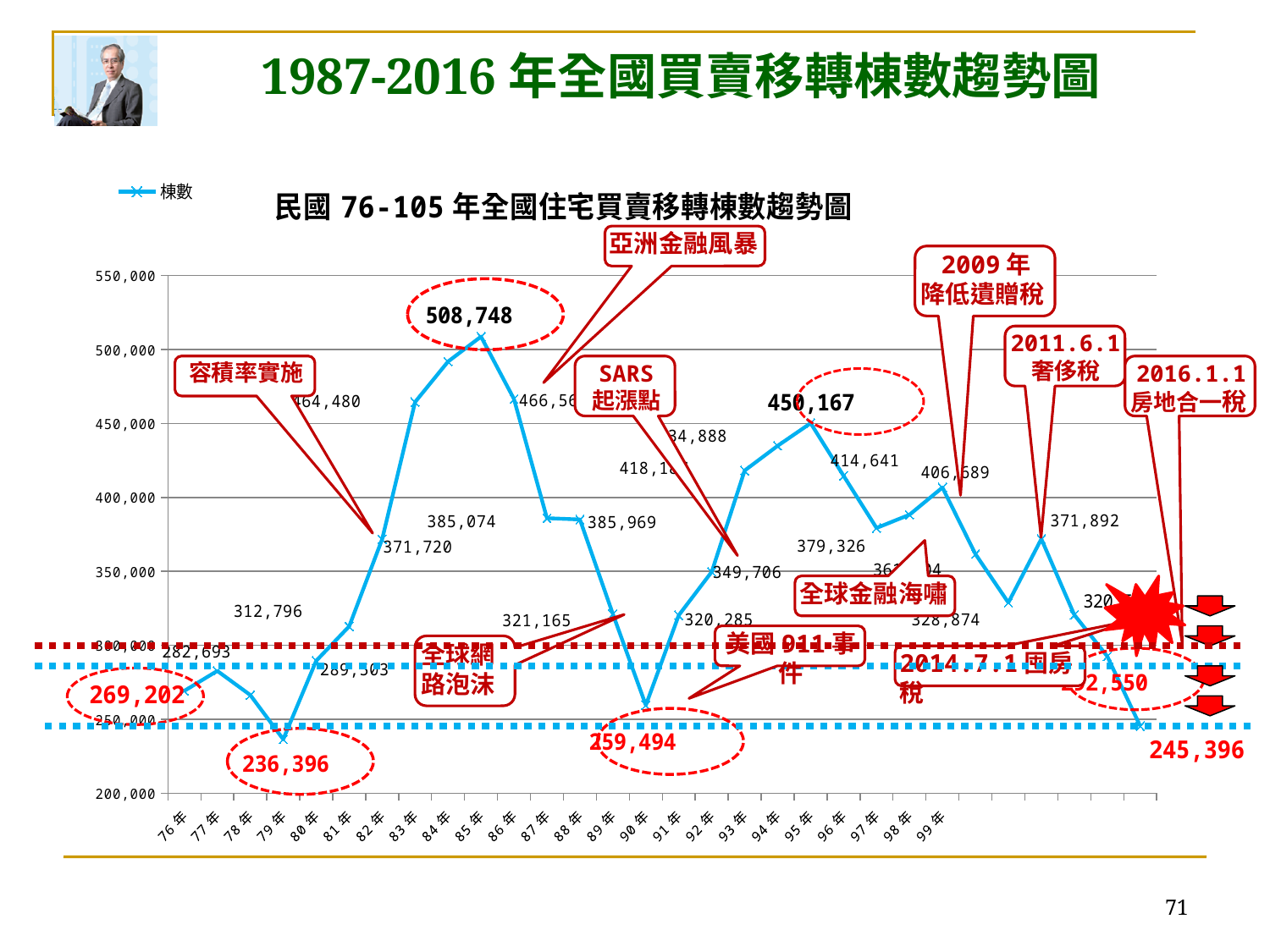
What type of chart is shown on the slide? line chart What is the lowest value plotted on the chart? 236,396 What is the value for 79年? 236,396 What is the highest value plotted on the chart? 508,748 Do the values rise or fall from 79年 to 85年? rise What is the value for 85年? 508,748 Is the value for 85年 greater or less than 500,000? greater What is the title of the chart? 民國 76-105 年全國住宅買賣移轉棟數趨勢圖 How many series does the legend list? 1 What is the value for 90年? 259,494 What is the difference between the peak value 508,748 and the lowest value 236,396? 272,352 Which is larger, the value for 85年 or the value for 79年? 85年